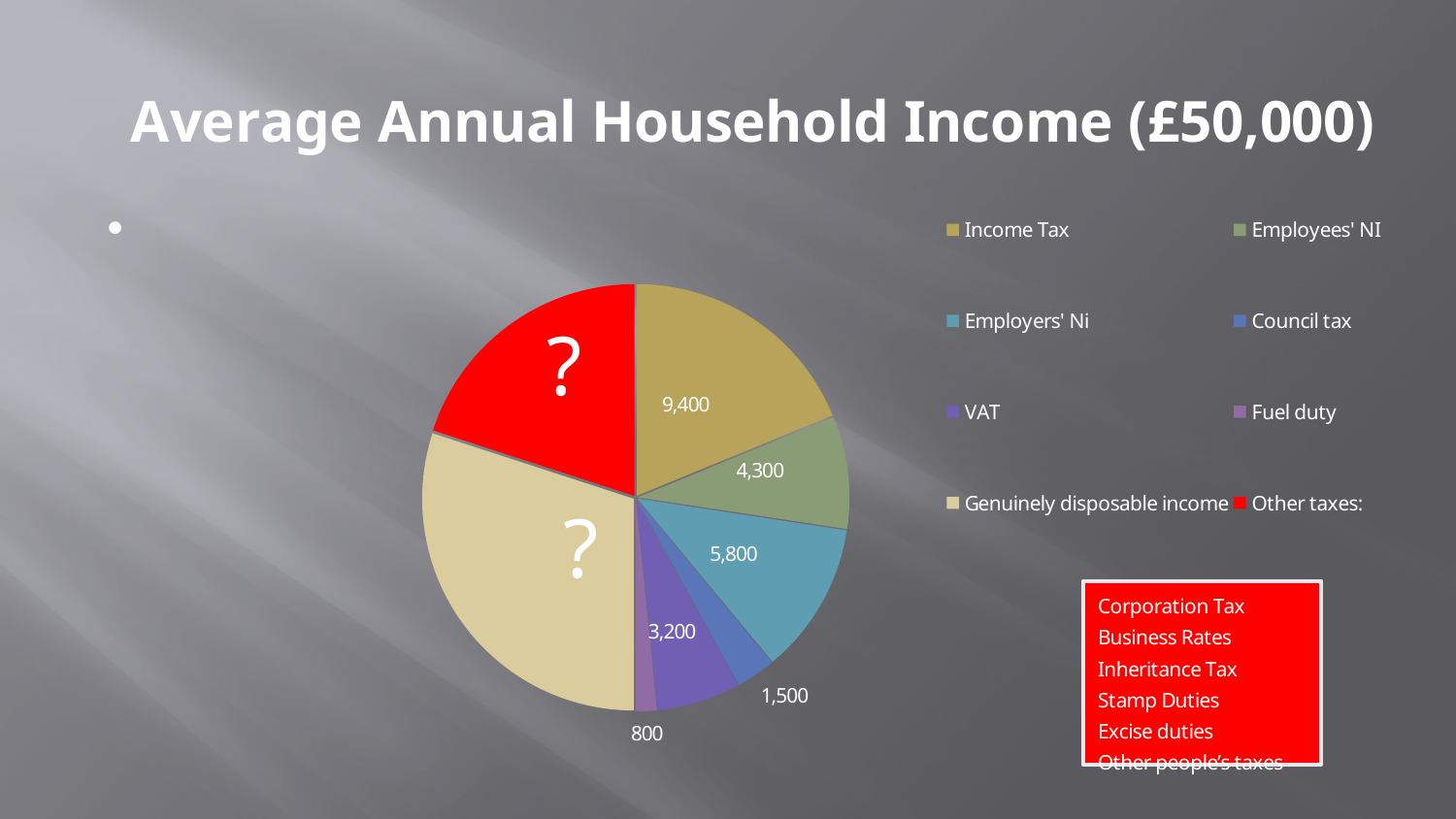
What type of chart is shown on the slide? pie chart What is the value of the Fuel duty slice? 800 How many categories does the legend list? 8 What is the value of the Employers' Ni slice? 5,800 Which is larger, the Employers' Ni slice or the Employees' NI slice? Employers' Ni What is the value of the Income Tax slice? 9,400 What is the value of the Employees' NI slice? 4,300 What is the value of the Council tax slice? 1,500 What is the title of the chart? Average Annual Household Income (£50,000) What is the value of the VAT slice? 3,200 Which category has the smallest slice in the pie chart? Fuel duty What is the difference between the Income Tax value and the Employees' NI value? 5,100